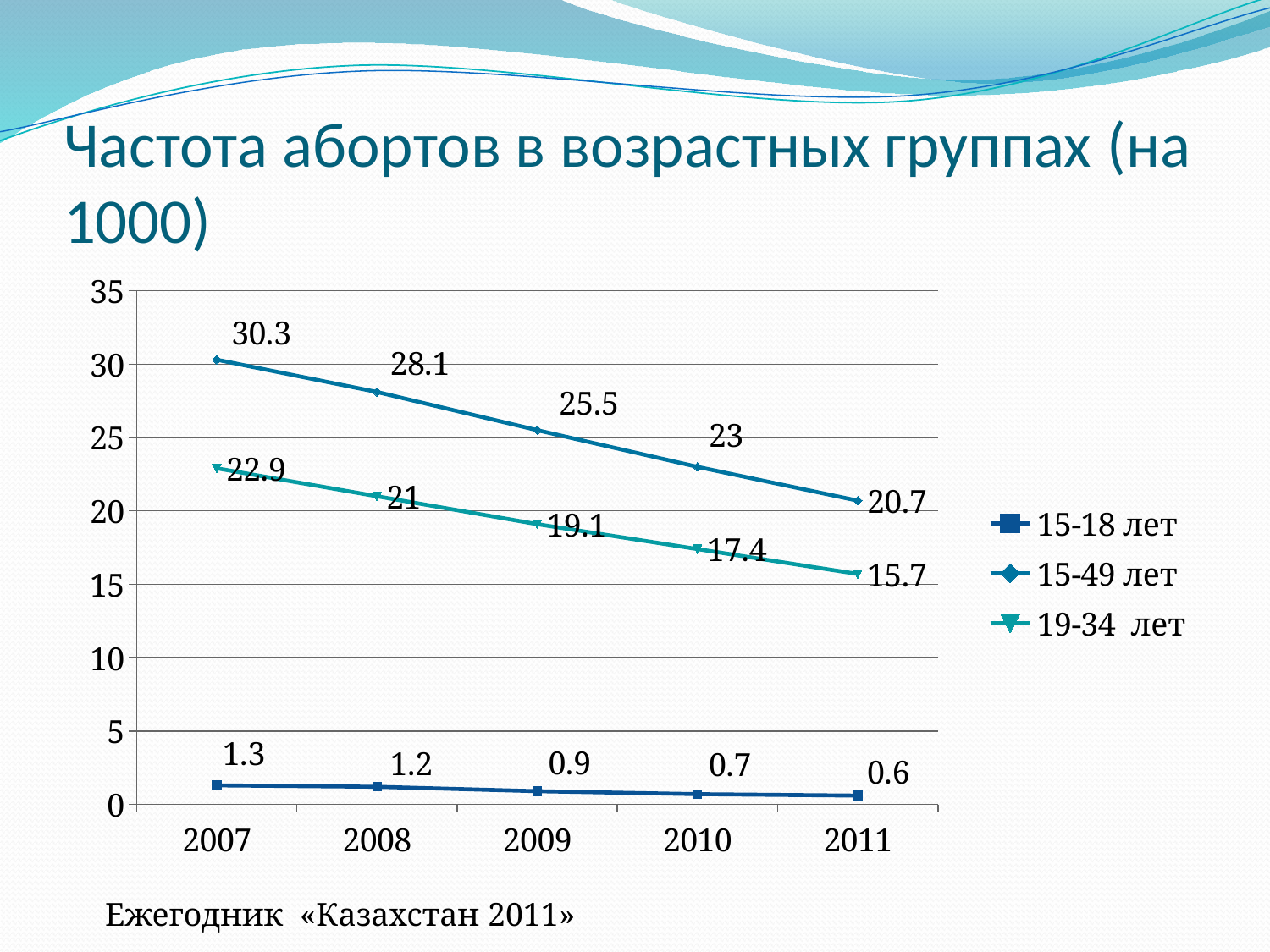
What is the value for the 15-18 лет series in 2011? 0.6 What kind of chart is shown on the slide? line chart Is the value for the 19-34 лет series in 2011 greater or less than 20? less What is the value for the 19-34 лет series in 2010? 17.4 In which year is the 15-49 лет series at its lowest? 2011 Does the 15-49 лет series rise or fall from 2007 to 2011? fall How many years are shown on the x axis? 5 How many series does the legend list? 3 What is the difference between the 15-49 лет and 19-34 лет values in 2009? 6.4 In which year is the 19-34 лет series at its highest? 2007 What is the value for the 15-49 лет series in 2007? 30.3 Which series has the larger value in 2008: 15-49 лет or 19-34 лет? 15-49 лет